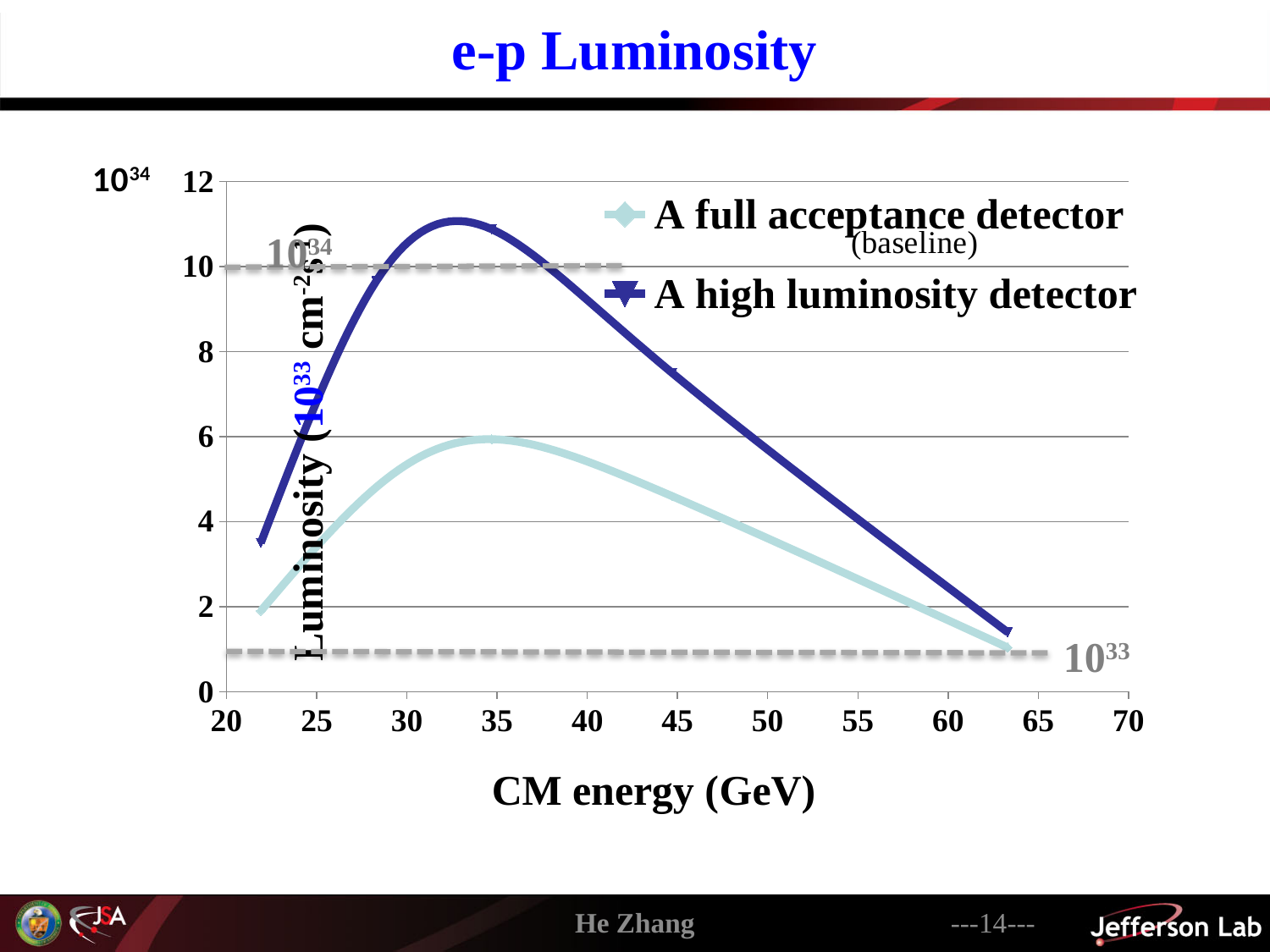
Is the value for the full acceptance detector at 60 GeV greater or less than 4? less How many series does the legend list? 2 Which series is drawn in dark blue according to the legend? A high luminosity detector Is the value for the full acceptance detector at 35 GeV greater or less than 8? less At a CM energy of 25 GeV, which series has the lower luminosity? A full acceptance detector Is the value for the high luminosity detector at 35 GeV greater or less than 10? greater Does the high luminosity detector curve rise or fall as CM energy increases from 35 GeV to 65 GeV? fall At a CM energy of 45 GeV, which series has the higher luminosity: the full acceptance detector or the high luminosity detector? A high luminosity detector Does the full acceptance detector curve rise or fall as CM energy increases from 20 GeV to 35 GeV? rise What kind of chart is shown on the slide? line chart What is the x-axis title of the chart? CM energy (GeV)